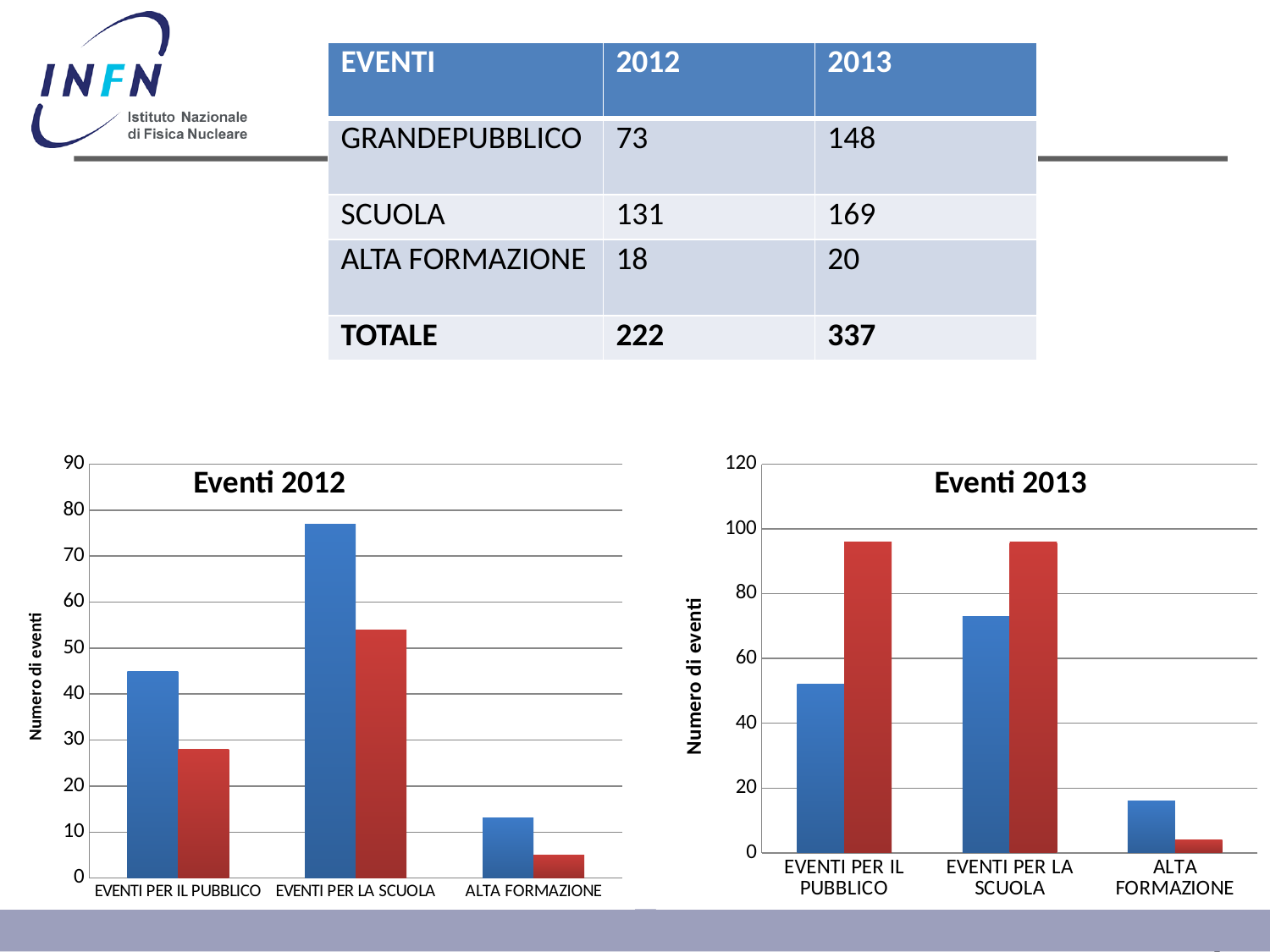
In the "Eventi 2013" chart, which category has the shortest blue bar? ALTA FORMAZIONE In the "Eventi 2012" chart, is the red bar for EVENTI PER IL PUBBLICO greater or less than 40? less How many categories are shown on the x axis of the "Eventi 2012" chart? 3 What kind of chart is the "Eventi 2012" chart? bar chart In the "Eventi 2012" chart, is the blue bar for EVENTI PER LA SCUOLA greater or less than 70? greater In the "Eventi 2012" chart, which category has the shortest red bar? ALTA FORMAZIONE In the "Eventi 2012" chart, for EVENTI PER LA SCUOLA, is the blue bar or the red bar taller? blue bar In the "Eventi 2013" chart, is the blue bar for EVENTI PER LA SCUOLA greater or less than 60? greater What is the y-axis title of the "Eventi 2013" chart? Numero di eventi In the "Eventi 2013" chart, for EVENTI PER IL PUBBLICO, is the blue bar or the red bar taller? red bar In the "Eventi 2012" chart, which category has the tallest blue bar? EVENTI PER LA SCUOLA